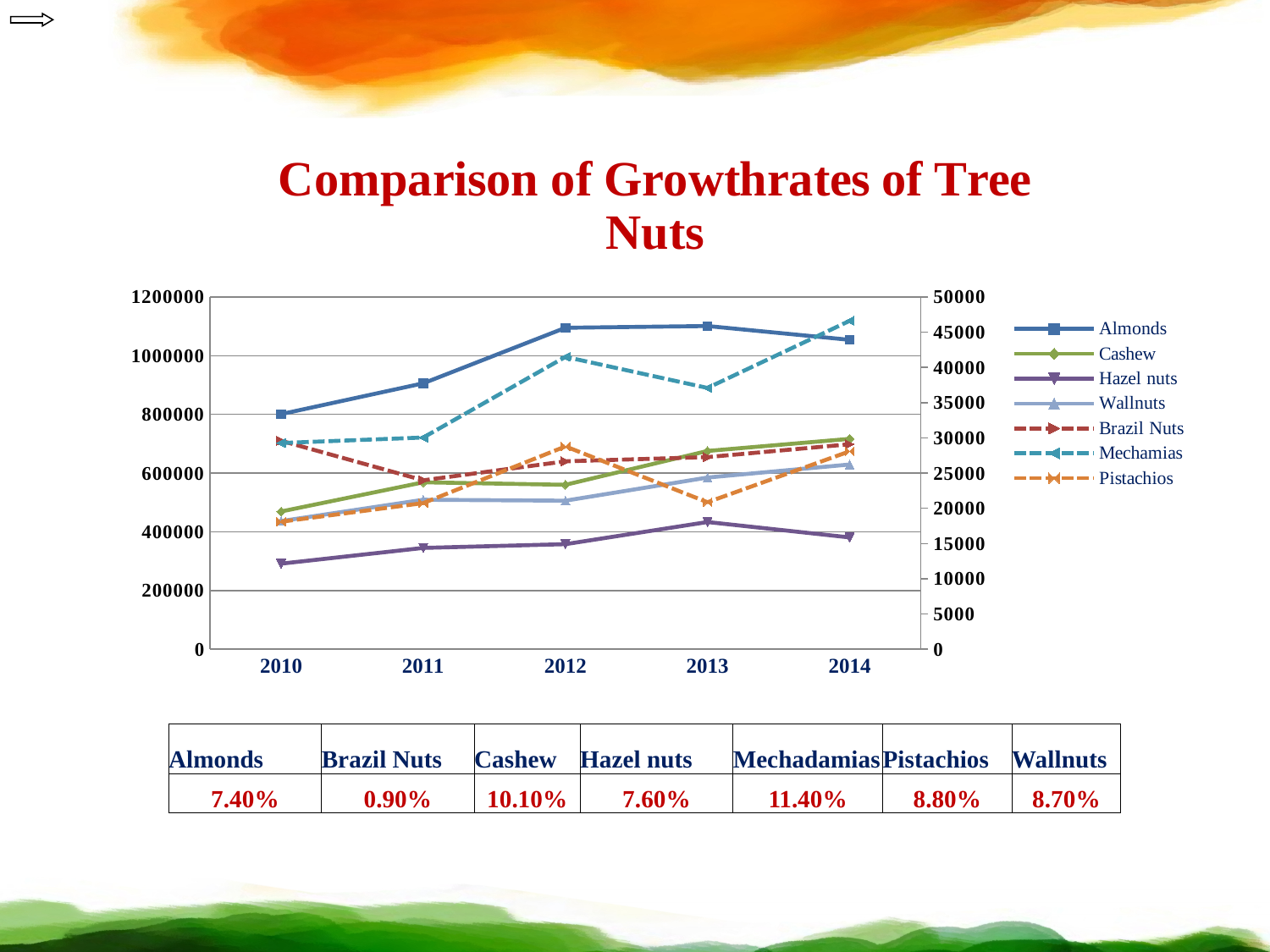
Is the value for Mechamias in 2014 greater or less than 45000 on the right axis? greater Which series is plotted highest on the chart in 2012? Almonds Is the value for Hazel nuts in 2010 greater or less than 400000 on the left axis? less Is the value for Cashew in 2014 greater or less than 600000 on the left axis? greater What is the title of the chart on the slide? Comparison of Growthrates of Tree Nuts What kind of chart is shown on the slide? line chart Which series is plotted lowest on the chart across all years? Hazel nuts Does the Cashew line generally rise or fall from 2010 to 2014? rise How many years are shown along the x axis of the chart? 5 Is the Almonds value higher in 2013 or in 2014? 2013 How many series does the chart legend list? 7